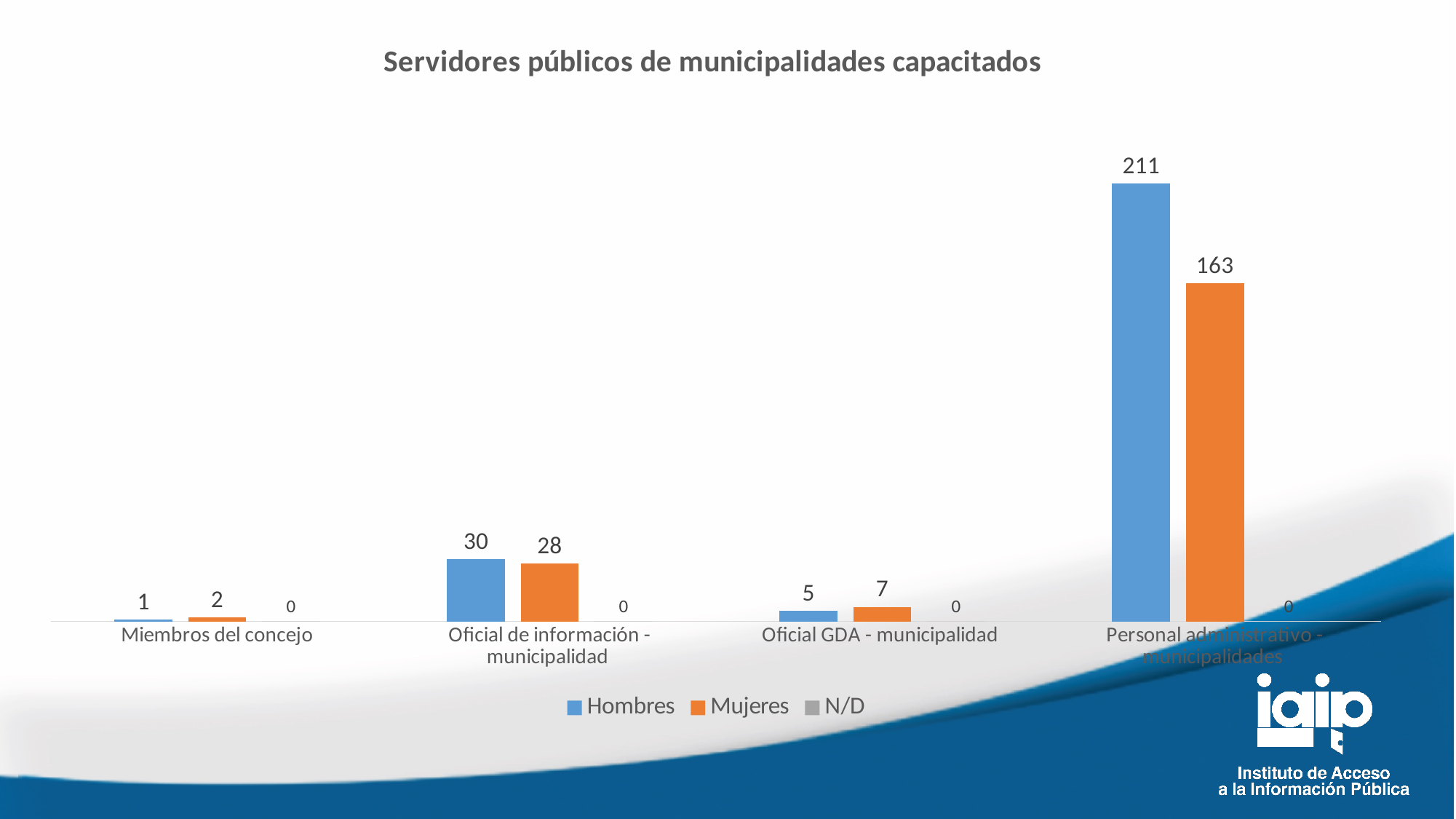
What is the value for Mujeres in the Miembros del concejo category? 2 What is the value for Mujeres in the Oficial de información - municipalidad category? 28 In the Oficial GDA - municipalidad category, which is larger, Hombres or Mujeres? Mujeres How many series does the legend list? 3 Which category has the lowest value for Hombres? Miembros del concejo Which category has the highest value for Mujeres? Personal administrativo - municipalidades What is the value for Hombres in the Oficial GDA - municipalidad category? 5 What is the title of the chart? Servidores públicos de municipalidades capacitados What is the value for Hombres in the Personal administrativo - municipalidades category? 211 What is the difference between Hombres and Mujeres in the Personal administrativo - municipalidades category? 48 How many categories are shown on the x axis? 4 What kind of chart is shown on the slide? Bar chart